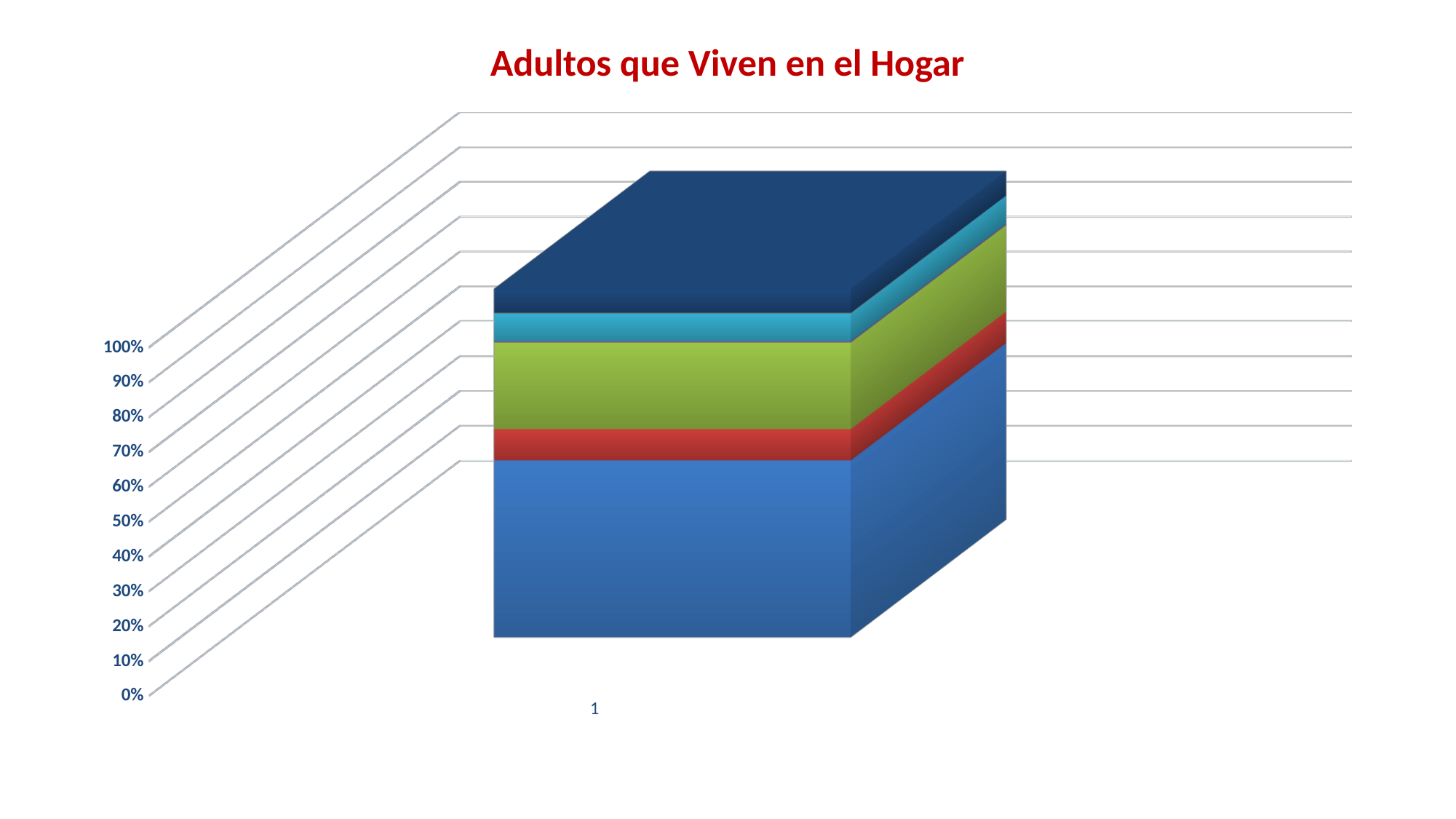
Which is larger, the green segment or the red segment? the green segment Which is larger, the blue segment or the green segment? the blue segment What is the title of the chart? Adultos que Viven en el Hogar Is the value of the green segment greater or less than 40%? less What is the label of the single category on the x axis? 1 Is the value of the red segment greater or less than 20%? less What kind of chart is shown on the slide? stacked bar chart What is the highest value shown on the vertical axis? 100% Which coloured segment of the stacked bar is the largest? the blue segment at the bottom How many categories are plotted on the x axis of the chart? 1 Is the value of the bottom blue segment greater or less than 40%? greater